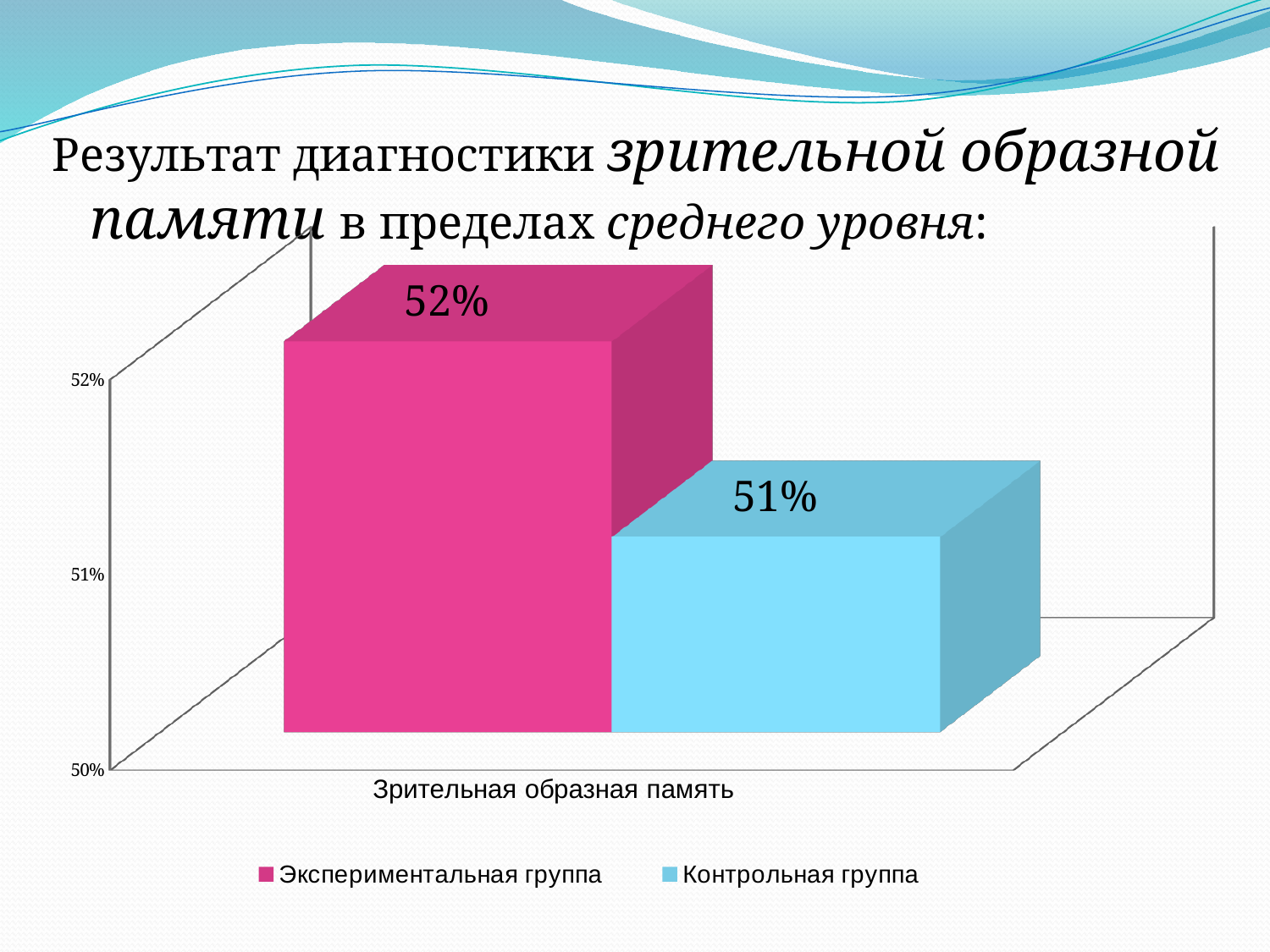
What kind of chart is shown? bar chart What is the value for Контрольная группа? 51% Which series has the higher value? Экспериментальная группа How many series does the legend list? 2 Is the value for Экспериментальная группа larger or smaller than the value for Контрольная группа? larger How many categories are shown on the x axis? 1 What colour is the bar for Контрольная группа? light blue What is the value for Экспериментальная группа? 52% What is the category label on the x axis? Зрительная образная память Which series has the lower value? Контрольная группа What is the difference between the values for Экспериментальная группа and Контрольная группа? 1% Is the value for Контрольная группа greater or less than 50%? greater